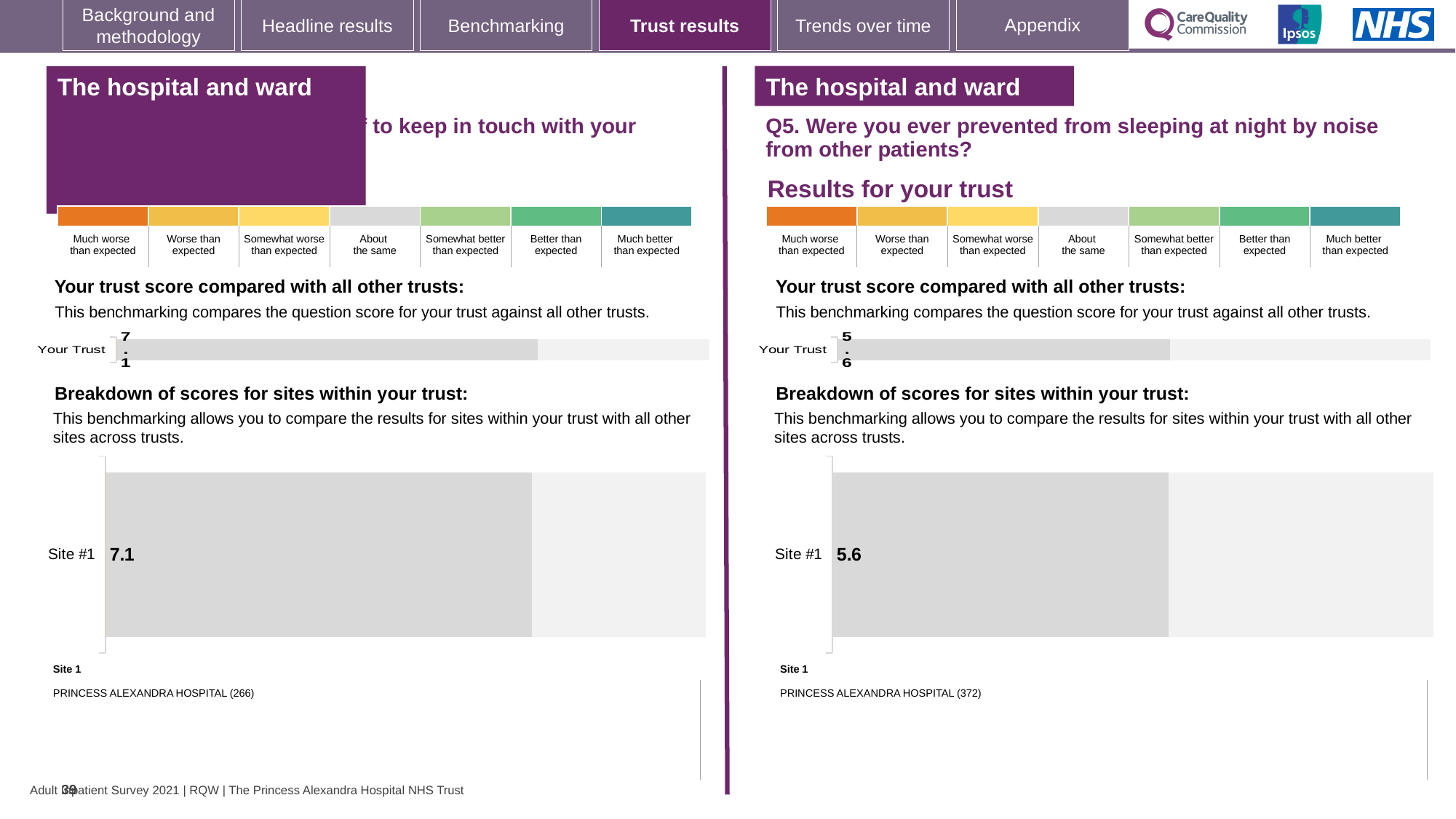
What is the difference between the Site #1 score on the left-hand side of the slide and the Site #1 score on the right-hand side (Q5)? 1.5 On the left-hand side of the slide, what score is shown for Site #1 in the breakdown of scores for sites within your trust? 7.1 How many sites are shown in the breakdown of scores for sites within your trust on the right-hand side of the slide (Q5)? 1 On the left-hand side of the slide, which hospital is listed as Site 1? PRINCESS ALEXANDRA HOSPITAL (266) On the right-hand side of the slide (Q5), which hospital is listed as Site 1? PRINCESS ALEXANDRA HOSPITAL (372) How many sites are shown in the breakdown of scores for sites within your trust on the left-hand side of the slide? 1 What kind of chart is used to show the Site #1 score on the right-hand side of the slide (Q5)? Bar chart On the left-hand side of the slide, what is the score shown for Your Trust? 7.1 Which is larger: the Your Trust score on the left-hand side of the slide or the Your Trust score on the right-hand side (Q5)? Left-hand side (7.1) On the right-hand side of the slide (Q5), what score is shown for Site #1 in the breakdown of scores for sites within your trust? 5.6 On the right-hand side of the slide (Q5, noise from other patients), what is the score shown for Your Trust? 5.6